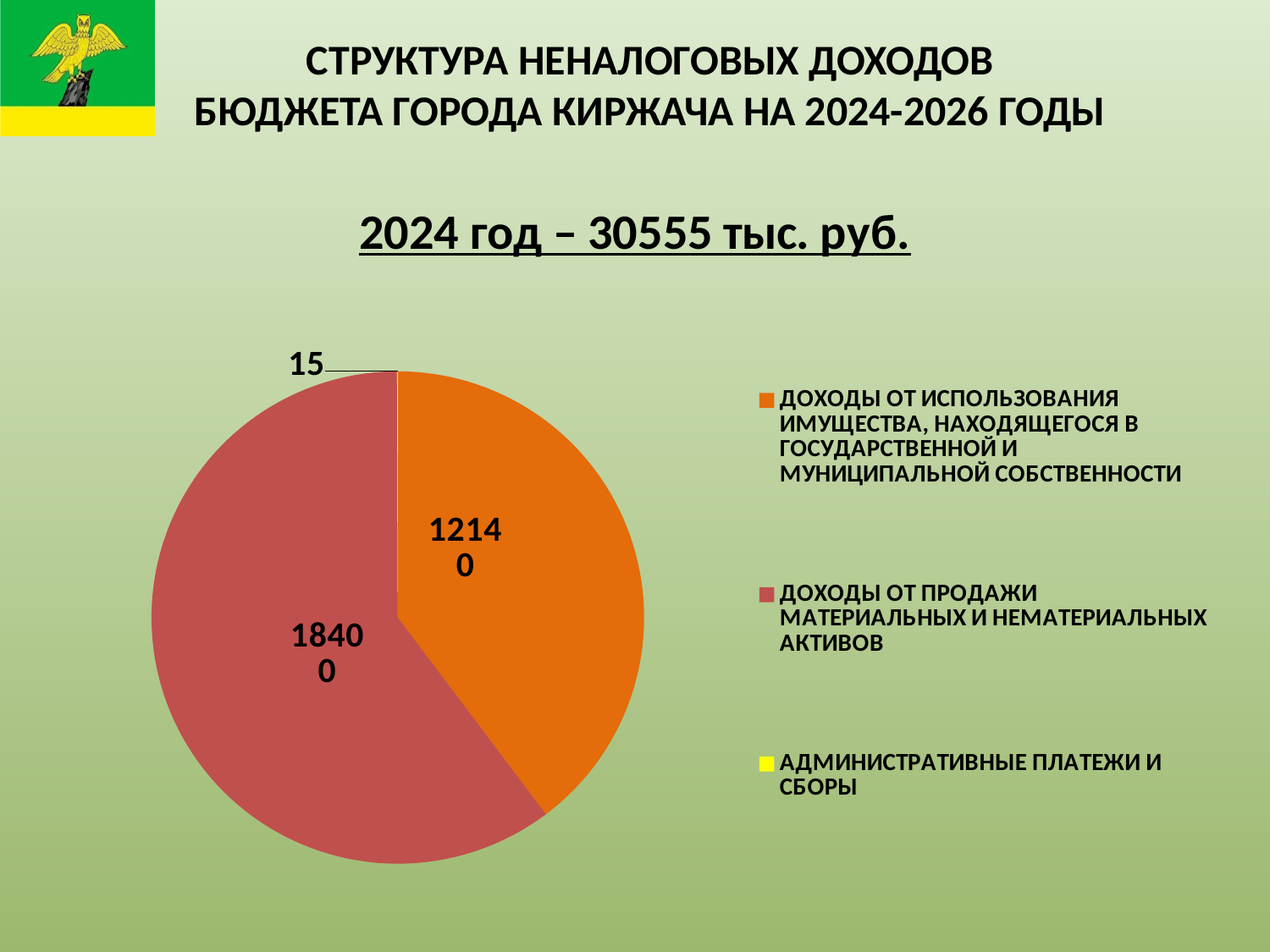
What type of chart is shown on the slide? pie chart What total amount for 2024 is stated in the heading above the chart? 30555 тыс. руб. Which is larger: the value for ДОХОДЫ ОТ ИСПОЛЬЗОВАНИЯ ИМУЩЕСТВА or the value for ДОХОДЫ ОТ ПРОДАЖИ МАТЕРИАЛЬНЫХ И НЕМАТЕРИАЛЬНЫХ АКТИВОВ? ДОХОДЫ ОТ ПРОДАЖИ МАТЕРИАЛЬНЫХ И НЕМАТЕРИАЛЬНЫХ АКТИВОВ What is the value for ДОХОДЫ ОТ ИСПОЛЬЗОВАНИЯ ИМУЩЕСТВА, НАХОДЯЩЕГОСЯ В ГОСУДАРСТВЕННОЙ И МУНИЦИПАЛЬНОЙ СОБСТВЕННОСТИ? 12140 What is the difference between the value for ДОХОДЫ ОТ ПРОДАЖИ МАТЕРИАЛЬНЫХ И НЕМАТЕРИАЛЬНЫХ АКТИВОВ and the value for ДОХОДЫ ОТ ИСПОЛЬЗОВАНИЯ ИМУЩЕСТВА? 6260 What is the value for ДОХОДЫ ОТ ПРОДАЖИ МАТЕРИАЛЬНЫХ И НЕМАТЕРИАЛЬНЫХ АКТИВОВ? 18400 What colour is the slice for ДОХОДЫ ОТ ИСПОЛЬЗОВАНИЯ ИМУЩЕСТВА, НАХОДЯЩЕГОСЯ В ГОСУДАРСТВЕННОЙ И МУНИЦИПАЛЬНОЙ СОБСТВЕННОСТИ? orange How many slices does the pie chart have? 3 Which category has the smallest slice of the pie? АДМИНИСТРАТИВНЫЕ ПЛАТЕЖИ И СБОРЫ How many entries does the legend list? 3 Which category has the largest slice of the pie? ДОХОДЫ ОТ ПРОДАЖИ МАТЕРИАЛЬНЫХ И НЕМАТЕРИАЛЬНЫХ АКТИВОВ What is the value for АДМИНИСТРАТИВНЫЕ ПЛАТЕЖИ И СБОРЫ? 15